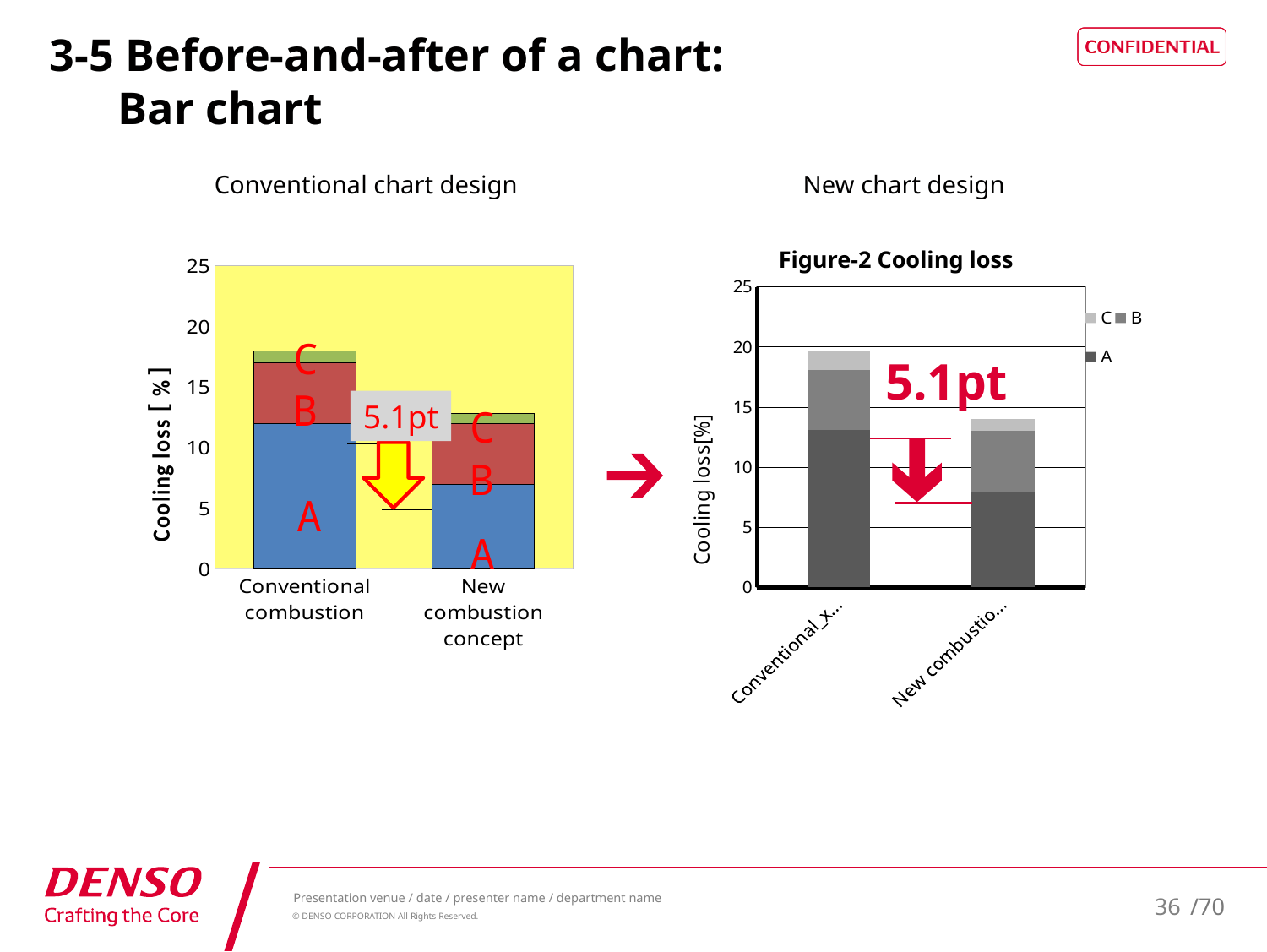
On the left chart (Conventional chart design), what kind of chart is shown? Stacked bar chart On the left chart (Conventional chart design), which category has the higher total cooling loss, Conventional combustion or New combustion concept? Conventional combustion On the left chart (Conventional chart design), is the total cooling loss for New combustion concept greater or less than 15? less On the right chart (Figure-2 Cooling loss), is the total of the left bar greater or less than 15? greater On the left chart (Conventional chart design), how many categories are shown on the x axis? 2 On the left chart (Conventional chart design), is the A segment for Conventional combustion greater or less than 10? greater On the right chart (Figure-2 Cooling loss), what reduction value is annotated between the two bars? 5.1pt On the right chart (Figure-2 Cooling loss), how many series does the legend list? 3 On the right chart (Figure-2 Cooling loss), what kind of chart is shown? Stacked bar chart What is the title of the right chart (New chart design)? Figure-2 Cooling loss